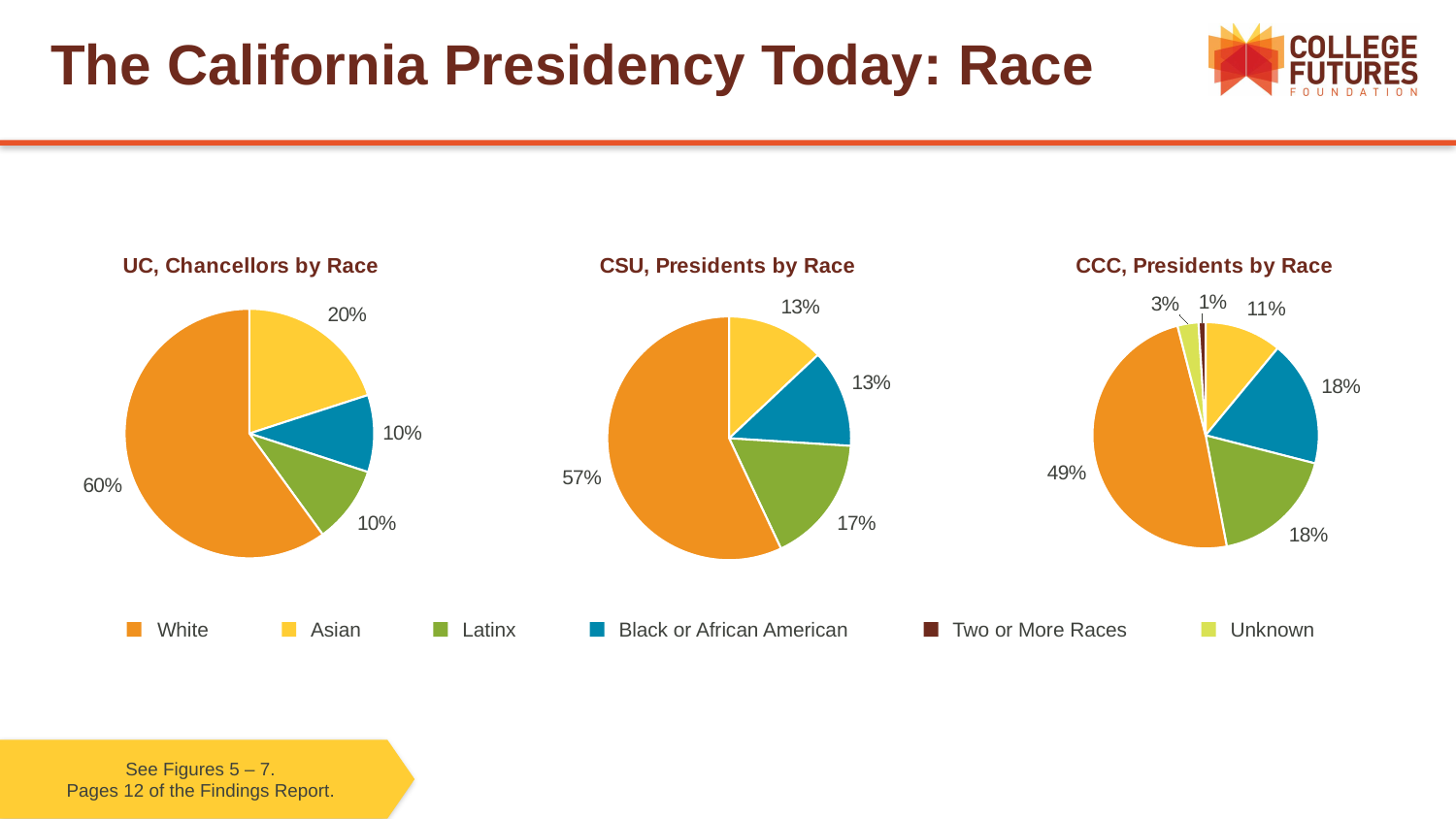
In the CSU, Presidents by Race chart, what share of presidents are Asian? 13% In the UC, Chancellors by Race chart, what is the difference between the White share and the Asian share? 40 percentage points How many entries does the shared legend list? 6 Is the White share larger in the UC, Chancellors by Race chart or the CCC, Presidents by Race chart? UC, Chancellors by Race In the CCC, Presidents by Race chart, which category has the smallest slice? Two or More Races In the UC, Chancellors by Race chart, which race has the largest slice? White In the CCC, Presidents by Race chart, what share of presidents are of Two or More Races? 1% In the UC, Chancellors by Race chart, what share of chancellors are White? 60% How many slices does the CCC, Presidents by Race pie chart have? 6 What type of chart is used for CSU, Presidents by Race? Pie chart In the CSU, Presidents by Race chart, what share of presidents are Latinx? 17% In the CCC, Presidents by Race chart, what share of presidents are White? 49%